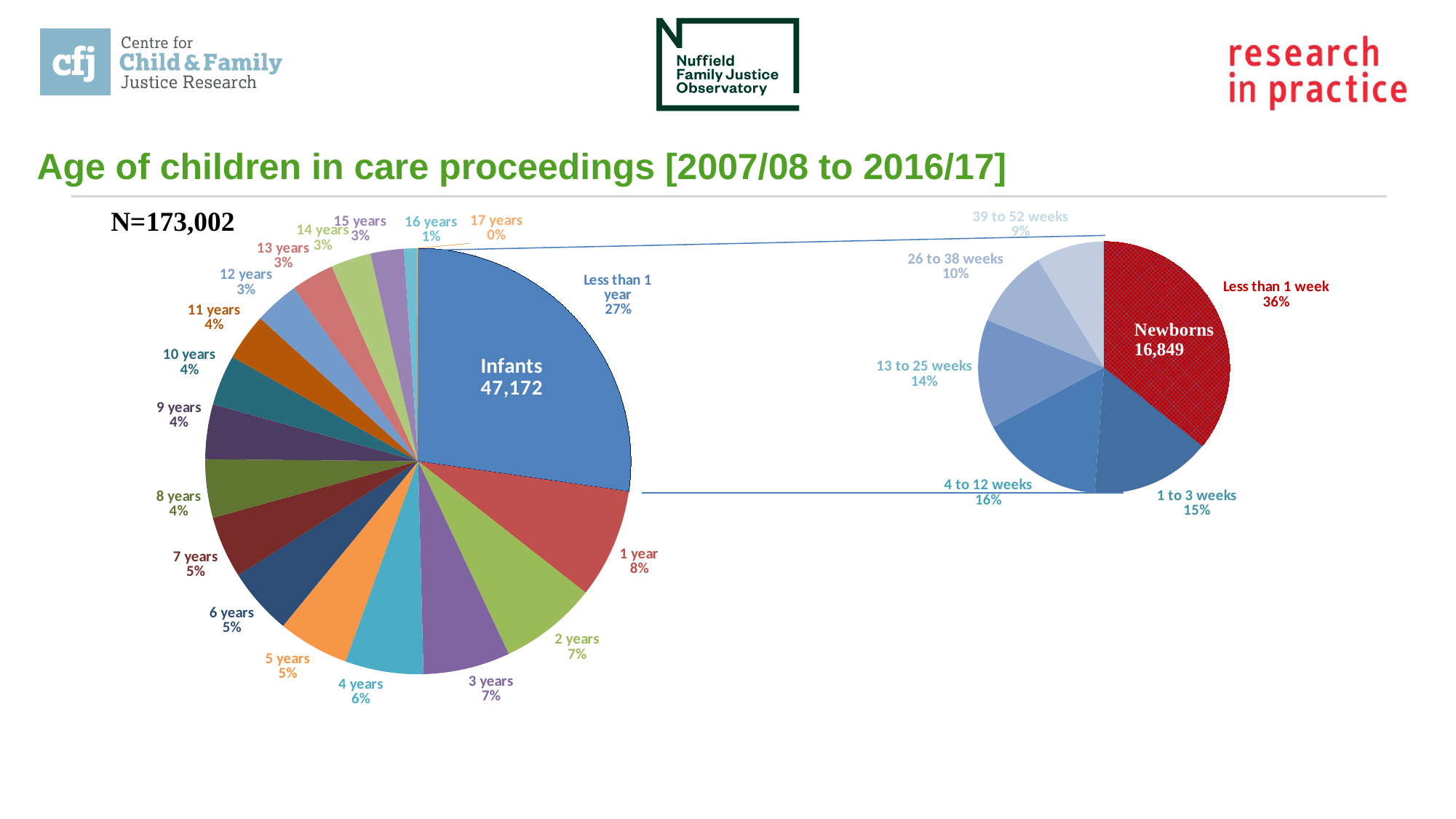
What kind of chart is the large chart on the left of the slide? pie chart In the small pie chart on the right, which is larger: the 4 to 12 weeks slice or the 1 to 3 weeks slice? 4 to 12 weeks In the large pie chart on the left, what share of children are 4 years old? 6% In the small pie chart on the right, how many categories are shown? 6 In the small pie chart on the right, what share of infants are less than 1 week old? 36% In the large pie chart on the left, what is the difference in percentage points between the 1 year slice and the 2 years slice? 1% In the large pie chart on the left, what share of children are less than 1 year old? 27% In the small pie chart on the right, what number of newborns is printed on the chart? 16,849 In the large pie chart on the left, which age category has the smallest share? 17 years In the large pie chart on the left, which age category has the largest share? Less than 1 year In the large pie chart on the left, how many age categories are shown? 18 In the large pie chart on the left, what number of infants is printed on the chart? 47,172